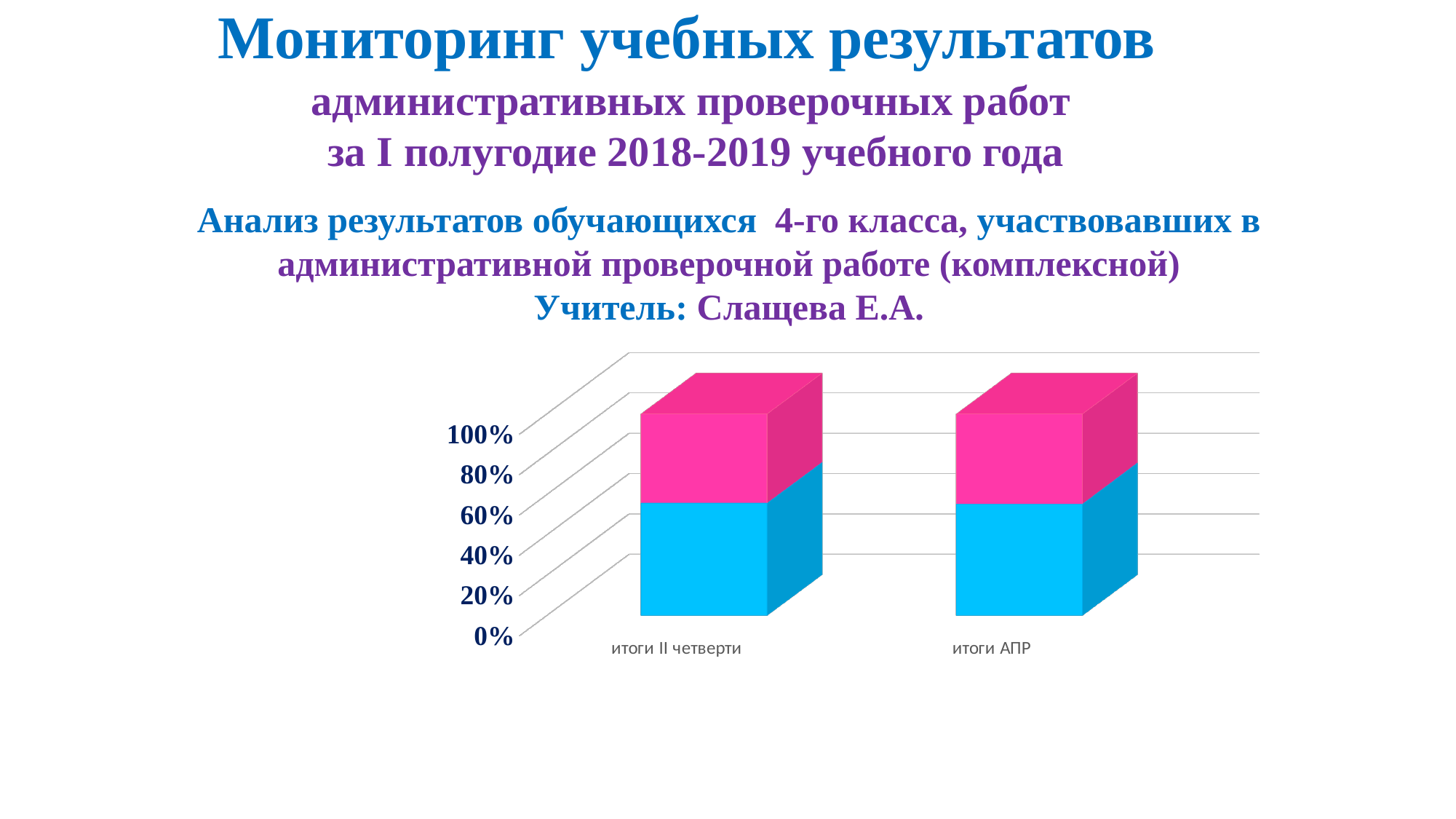
Is the total height of the stacked bar for "итоги II четверти" greater or less than 80%? greater Is the total height of the stacked bar for "итоги АПР" greater or less than 80%? greater What is the label of the first category on the x axis? итоги II четверти Is the blue segment for "итоги АПР" greater or less than 40%? greater What is the highest value shown on the y axis of the chart? 100% What kind of chart is shown on the slide? bar chart How many categories are shown on the x axis of the chart? 2 What is the label of the second category on the x axis? итоги АПР